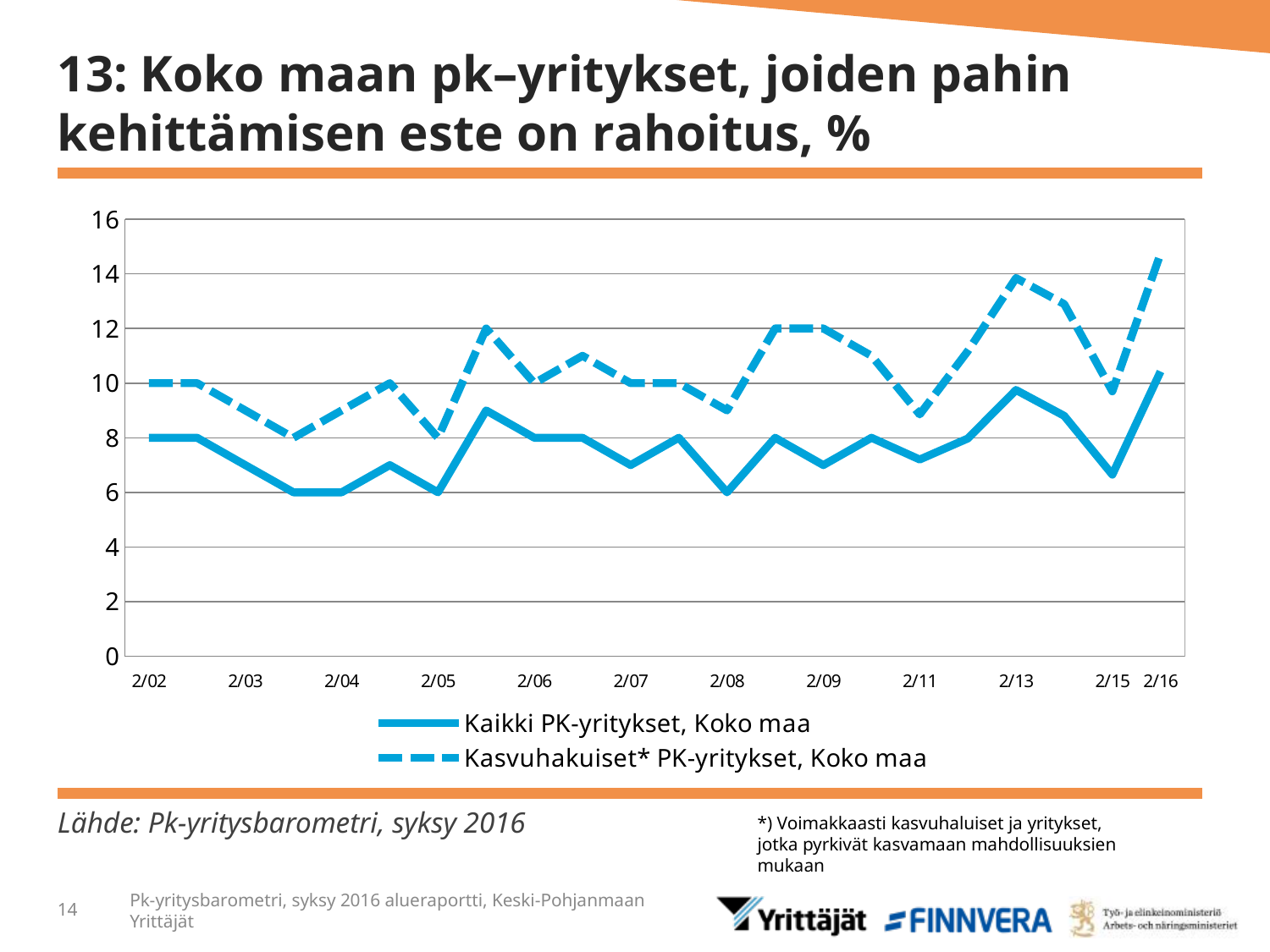
What is the value for Kaikki PK-yritykset, Koko maa at 2/02? 8 Does the value for Kaikki PK-yritykset, Koko maa rise or fall from 2/15 to 2/16? Rise What is the value for Kasvuhakuiset* PK-yritykset, Koko maa at 2/02? 10 Is the value for Kasvuhakuiset* PK-yritykset, Koko maa at 2/16 greater or less than 14? greater At 2/09, which series has the higher value: Kaikki PK-yritykset, Koko maa or Kasvuhakuiset* PK-yritykset, Koko maa? Kasvuhakuiset* PK-yritykset, Koko maa How many series does the legend list? 2 What is the value for Kasvuhakuiset* PK-yritykset, Koko maa at 2/09? 12 Is the value for Kasvuhakuiset* PK-yritykset, Koko maa at 2/11 greater or less than 10? less What is the value for Kaikki PK-yritykset, Koko maa at 2/04? 6 Is the value for Kaikki PK-yritykset, Koko maa at 2/15 greater or less than 8? less Which series is drawn with a dashed line? Kasvuhakuiset* PK-yritykset, Koko maa What type of chart is shown on the slide? Line chart